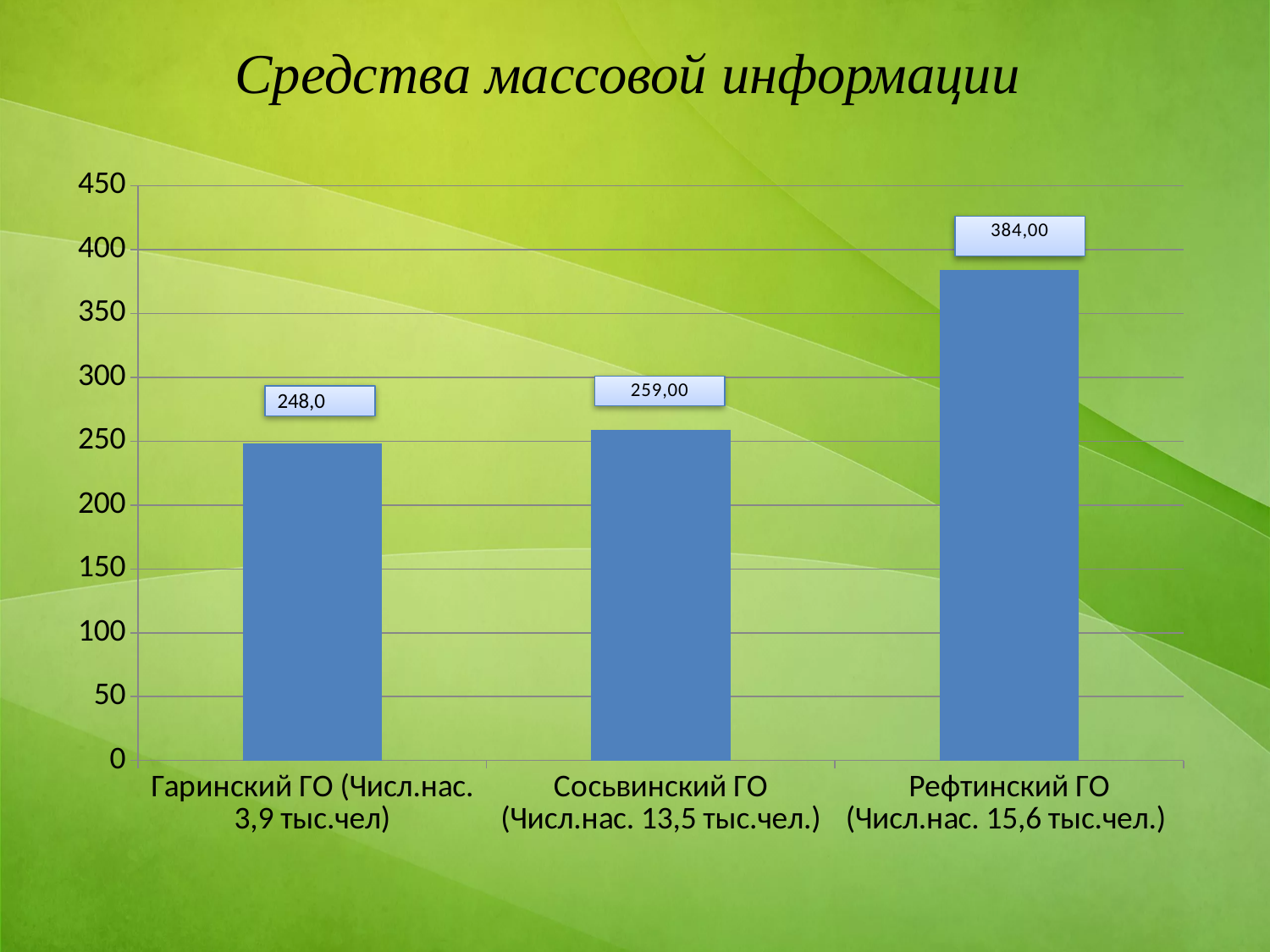
Is the value for Рефтинский ГО greater or less than 350? greater What is the value for Рефтинский ГО? 384,00 How many categories are shown on the chart? 3 Which is larger, the value for Рефтинский ГО or the value for Сосьвинский ГО? Рефтинский ГО What is the value for Сосьвинский ГО? 259,00 What is the difference between the values for Сосьвинский ГО and Гаринский ГО? 11 What is the title of the slide? Средства массовой информации What kind of chart is shown on the slide? bar chart Which category has the highest value? Рефтинский ГО What is the difference between the values for Рефтинский ГО and Гаринский ГО? 136 Which category has the lowest value? Гаринский ГО What is the value for Гаринский ГО? 248,0